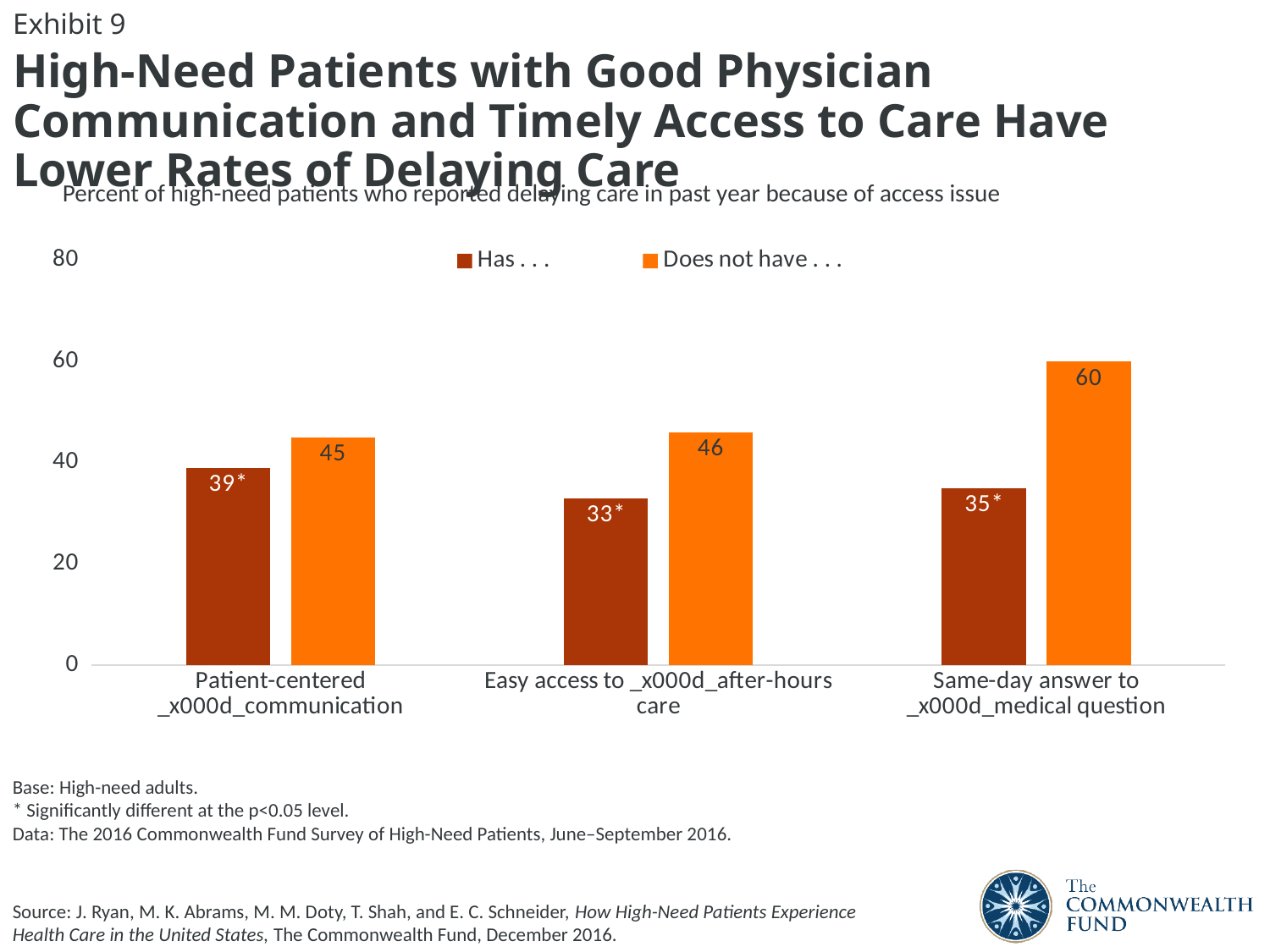
What is the difference between the "Does not have . . ." and "Has . . ." values in the Patient-centered communication category? 6 What is the value for "Does not have . . ." in the Easy access to after-hours care category? 46 What is the value for "Does not have . . ." in the Same-day answer to medical question category? 60 Which category has the lowest value for the "Has . . ." series? Easy access to after-hours care How many categories are shown on the x axis? 3 What is the value for "Has . . ." in the Patient-centered communication category? 39* In the Easy access to after-hours care category, which series has the larger value, "Has . . ." or "Does not have . . ."? Does not have . . . Which category has the highest value for the "Does not have . . ." series? Same-day answer to medical question What colour are the bars for the "Does not have . . ." series? Orange How many series does the legend list? 2 What kind of chart is shown on the slide? Bar chart What is the difference between the "Does not have . . ." and "Has . . ." values in the Same-day answer to medical question category? 25